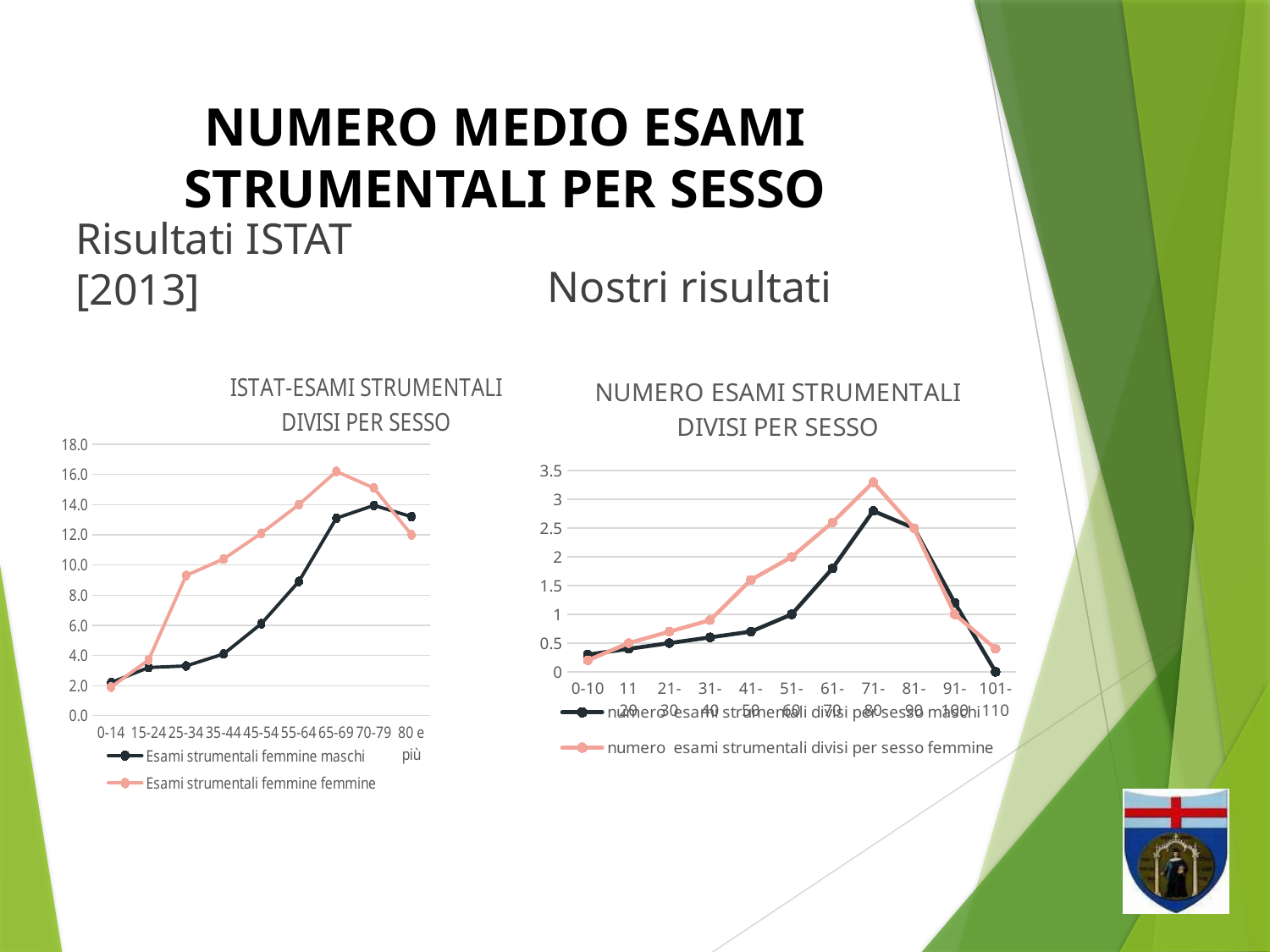
In the right chart (NUMERO ESAMI STRUMENTALI DIVISI PER SESSO), which series has the larger value at 61-70, maschi or femmine? femmine In the right chart (NUMERO ESAMI STRUMENTALI DIVISI PER SESSO), how many series does the legend list? 2 In the left chart (ISTAT-ESAMI STRUMENTALI DIVISI PER SESSO), is the value for femmine at 25-34 greater or less than 8.0? greater In the left chart (ISTAT-ESAMI STRUMENTALI DIVISI PER SESSO), which age category has the lowest value for the maschi series? 0-14 In the right chart (NUMERO ESAMI STRUMENTALI DIVISI PER SESSO), what is the value for femmine at 51-60? 2 In the left chart (ISTAT-ESAMI STRUMENTALI DIVISI PER SESSO), which age category has the highest value for the femmine series? 65-69 In the left chart (ISTAT-ESAMI STRUMENTALI DIVISI PER SESSO), is the value for maschi at 70-79 greater or less than 12.0? greater In the right chart (NUMERO ESAMI STRUMENTALI DIVISI PER SESSO), what is the value for maschi at 51-60? 1 What kind of chart is the left chart titled 'ISTAT-ESAMI STRUMENTALI DIVISI PER SESSO'? line chart In the left chart (ISTAT-ESAMI STRUMENTALI DIVISI PER SESSO), how many age categories are shown on the x axis? 9 In the right chart (NUMERO ESAMI STRUMENTALI DIVISI PER SESSO), what is the value for maschi at 101-110? 0 In the right chart (NUMERO ESAMI STRUMENTALI DIVISI PER SESSO), which age category has the highest value for the femmine series? 71-80